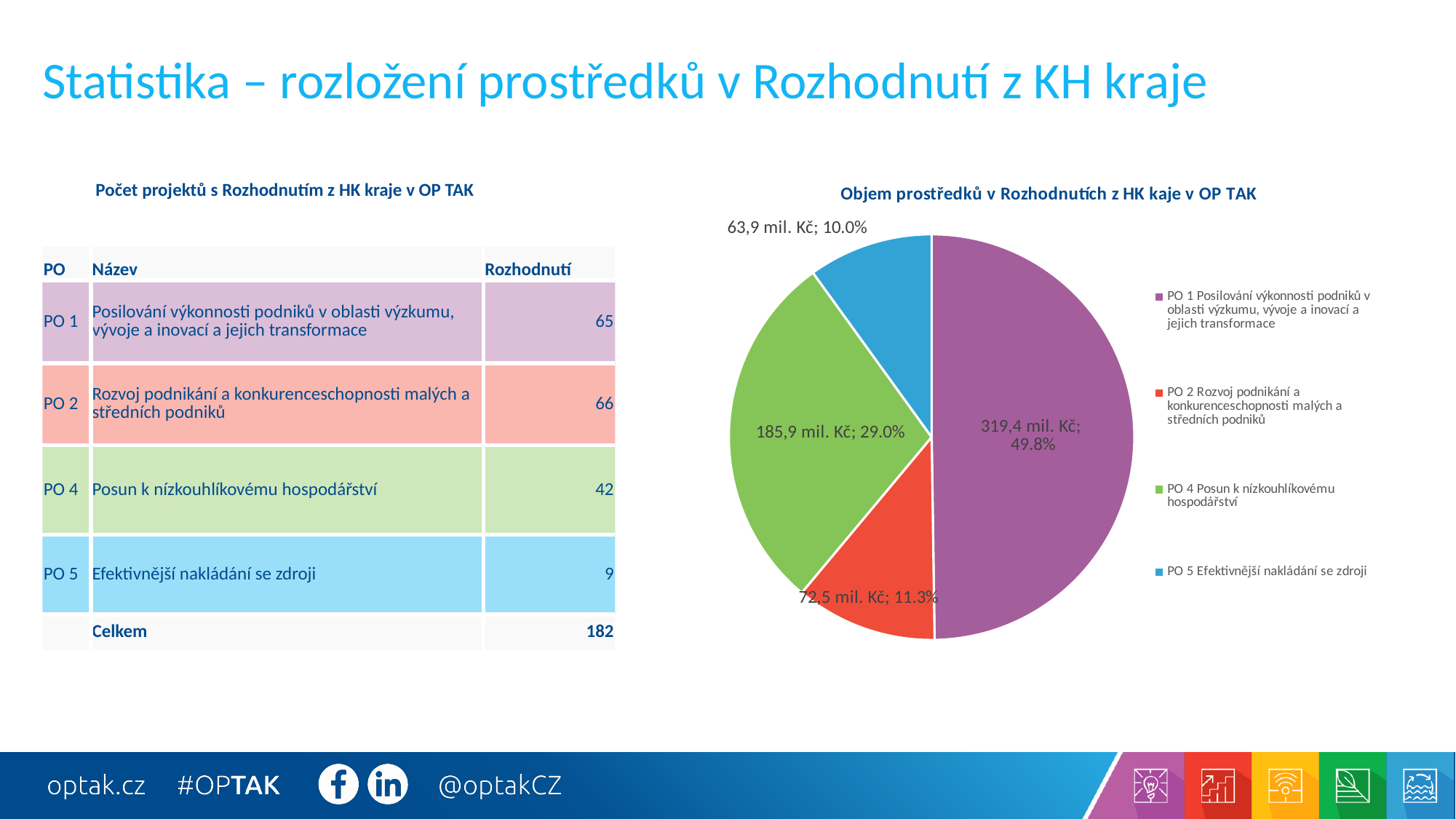
What kind of chart is shown on the slide? pie chart How many slices does the pie chart have? 4 What value is shown for PO 4 Posun k nízkouhlíkovému hospodářství in the pie chart? 185,9 mil. Kč What share of the pie does PO 2 Rozvoj podnikání a konkurenceschopnosti malých a středních podniků represent? 11.3% How many entries does the pie chart's legend list? 4 What share of the pie does PO 5 Efektivnější nakládání se zdroji represent? 10.0% Which category has the largest slice in the pie chart? PO 1 Posilování výkonnosti podniků v oblasti výzkumu, vývoje a inovací a jejich transformace What is the title of the pie chart? Objem prostředků v Rozhodnutích z HK kaje v OP TAK What value is shown for PO 1 Posilování výkonnosti podniků in the pie chart? 319,4 mil. Kč Which category has the smallest slice in the pie chart? PO 5 Efektivnější nakládání se zdroji What is the difference between the values for PO 1 and PO 4 in the pie chart? 133,5 mil. Kč In the pie chart, which is larger: the value for PO 2 or the value for PO 4? PO 4